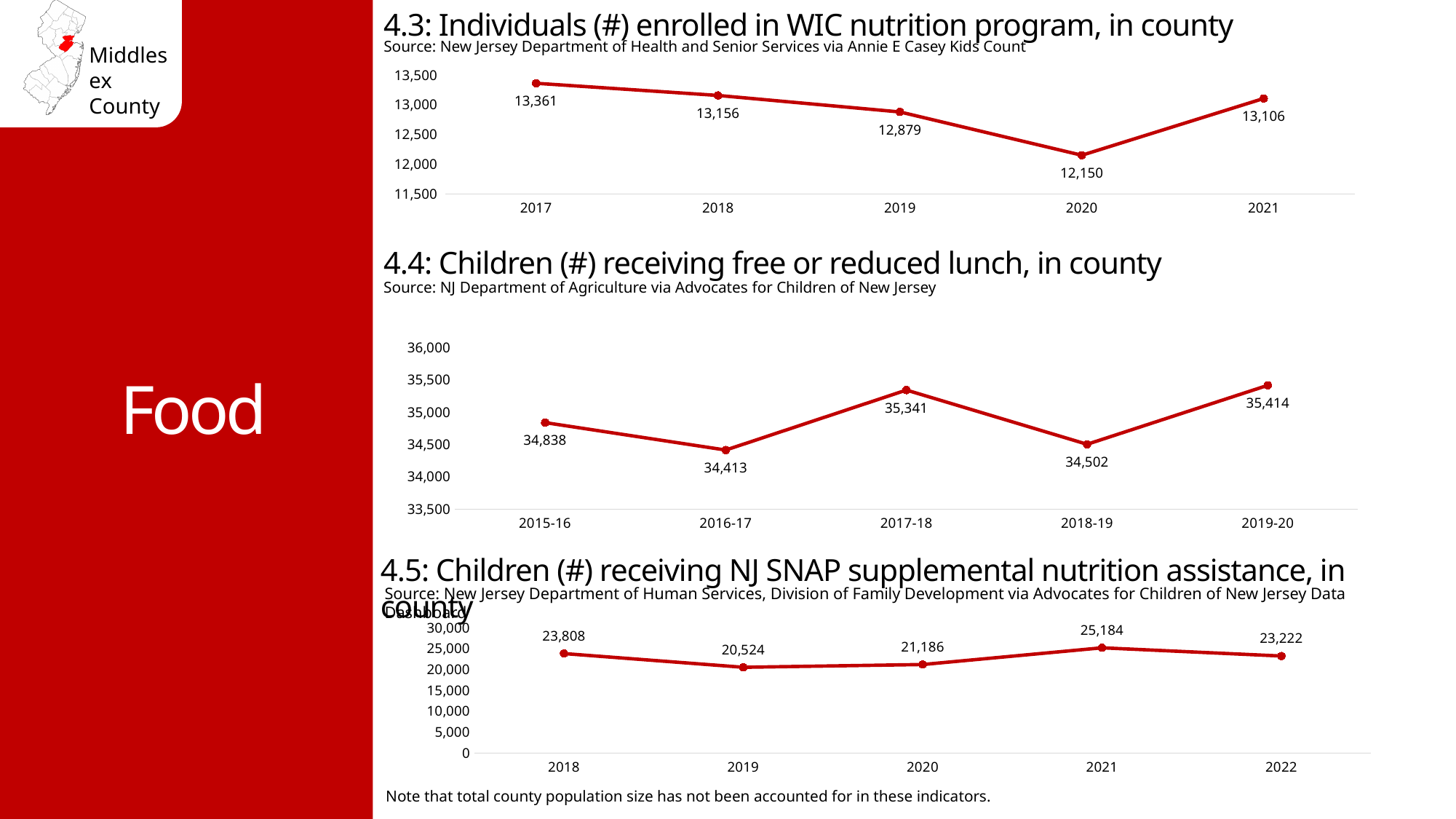
In the chart '4.4: Children (#) receiving free or reduced lunch, in county', which school year has the lowest value? 2016-17 In the chart '4.5: Children (#) receiving NJ SNAP supplemental nutrition assistance, in county', is the value for 2018 greater or less than 20,000? greater In the chart '4.3: Individuals (#) enrolled in WIC nutrition program, in county', what is the difference between the 2017 and 2021 values? 255 In the chart '4.5: Children (#) receiving NJ SNAP supplemental nutrition assistance, in county', what is the value for 2021? 25,184 In the chart '4.3: Individuals (#) enrolled in WIC nutrition program, in county', which year has the highest value? 2017 In the chart '4.5: Children (#) receiving NJ SNAP supplemental nutrition assistance, in county', which year has the lowest value? 2019 In the chart '4.3: Individuals (#) enrolled in WIC nutrition program, in county', how many years are plotted? 5 In the chart '4.5: Children (#) receiving NJ SNAP supplemental nutrition assistance, in county', what is the difference between the 2021 and 2019 values? 4,660 In the chart '4.3: Individuals (#) enrolled in WIC nutrition program, in county', what is the value for 2020? 12,150 In the chart '4.4: Children (#) receiving free or reduced lunch, in county', what kind of chart is shown? line chart In the chart '4.4: Children (#) receiving free or reduced lunch, in county', what is the value for 2016-17? 34,413 In the chart '4.4: Children (#) receiving free or reduced lunch, in county', is the value for 2017-18 larger or smaller than the value for 2019-20? smaller